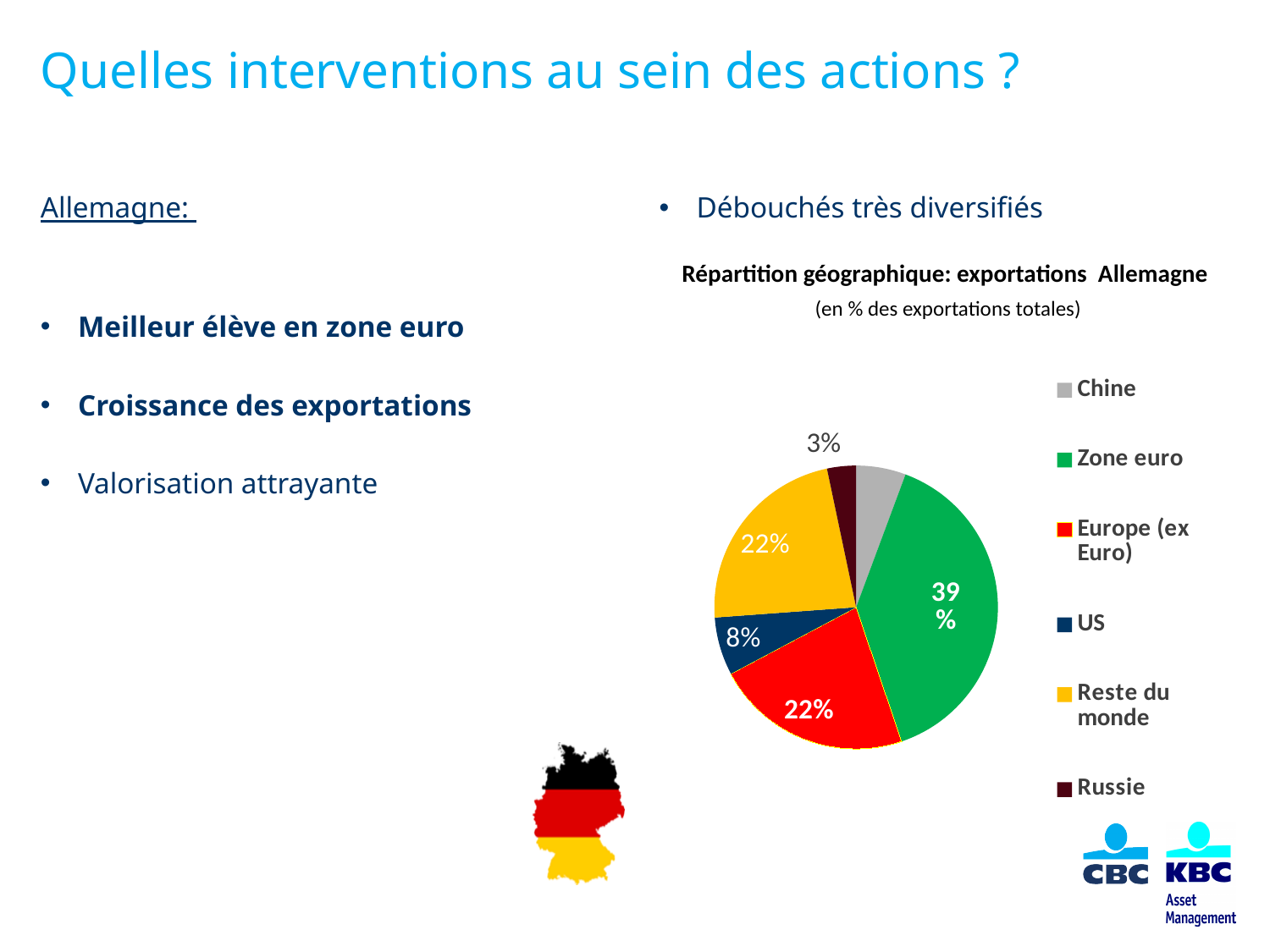
What share of German exports goes to Europe (ex Euro)? 22% What is the difference between the Zone euro share and the US share? 31% What share of German exports goes to Russie? 3% What kind of chart is shown on the slide? pie chart Which is larger, the share for Zone euro or the share for US? Zone euro What colour represents Zone euro in the pie chart? green What is the title of the chart? Répartition géographique: exportations Allemagne What share of German exports goes to the Zone euro? 39% How many categories does the chart's legend list? 6 What share of German exports goes to Reste du monde? 22% What share of German exports goes to the US? 8% Which category has the largest share of German exports? Zone euro